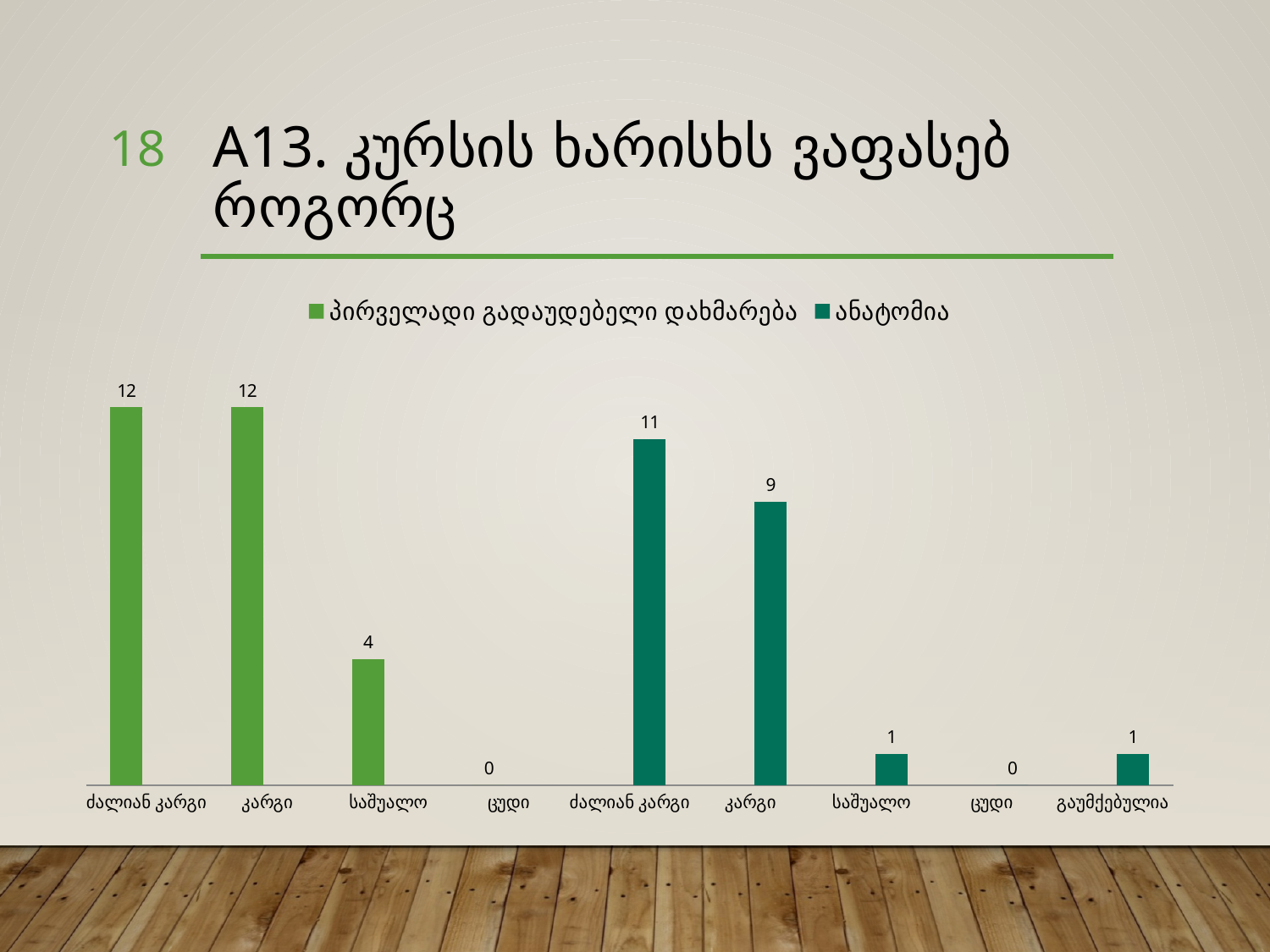
What is the value of the 'ძალიან კარგი' bar in the 'პირველადი გადაუდებელი დახმარება' series? 12 What type of chart is shown on the slide? bar chart What is the value of the 'ძალიან კარგი' bar in the 'ანატომია' series? 11 What is the title of the chart on the slide? A13. კურსის ხარისხს ვაფასებ როგორც What is the value of the 'ცუდი' bar in the 'ანატომია' series? 0 Which is larger: the 'საშუალო' value for 'პირველადი გადაუდებელი დახმარება' or the 'საშუალო' value for 'ანატომია'? პირველადი გადაუდებელი დახმარება What is the value of the 'კარგი' bar in the 'ანატომია' series? 9 What is the difference between the 'ძალიან კარგი' and 'კარგი' values in the 'ანატომია' series? 2 How many series does the legend list? 2 How many bars (categories) are plotted on the chart in total? 9 What is the value of the 'საშუალო' bar in the 'პირველადი გადაუდებელი დახმარება' series? 4